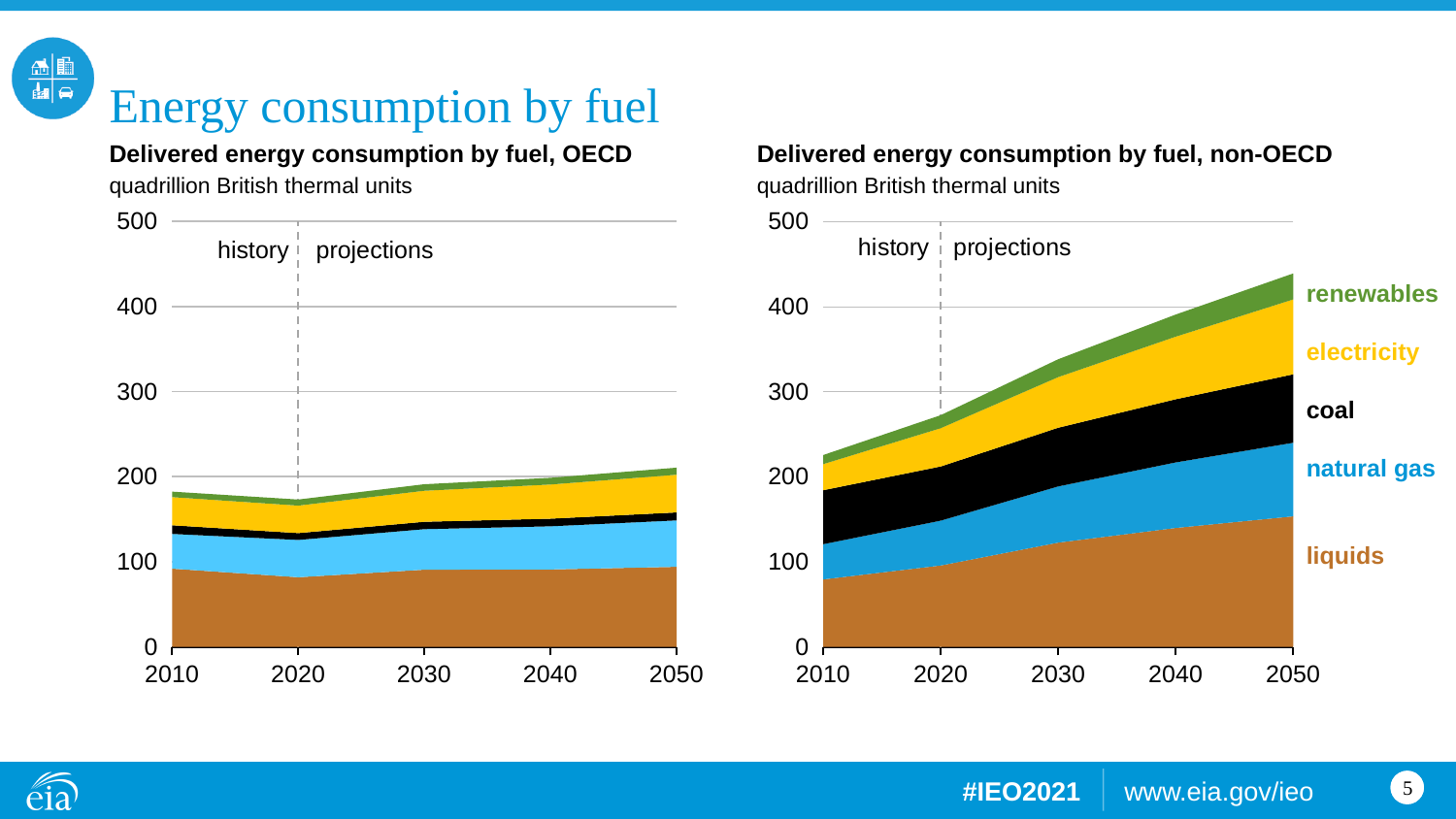
How many year labels are shown on the x axis of the OECD chart? 5 In the non-OECD chart, is the total delivered energy consumption in 2050 greater or less than 400? greater In the non-OECD chart, does total delivered energy consumption rise or fall from 2010 to 2050? rise Which chart shows the larger total delivered energy consumption in 2050, the OECD chart or the non-OECD chart? non-OECD What unit of measurement is used on both charts? quadrillion British thermal units In the non-OECD chart, is the total delivered energy consumption in 2030 greater or less than 300? greater In the non-OECD chart, which fuel series is shown at the bottom of the stack? liquids In the OECD chart, is the total delivered energy consumption in 2010 greater or less than 200? less How many fuel series does the legend on the non-OECD chart list? 5 What kind of chart is the 'Delivered energy consumption by fuel, non-OECD' chart? stacked area chart